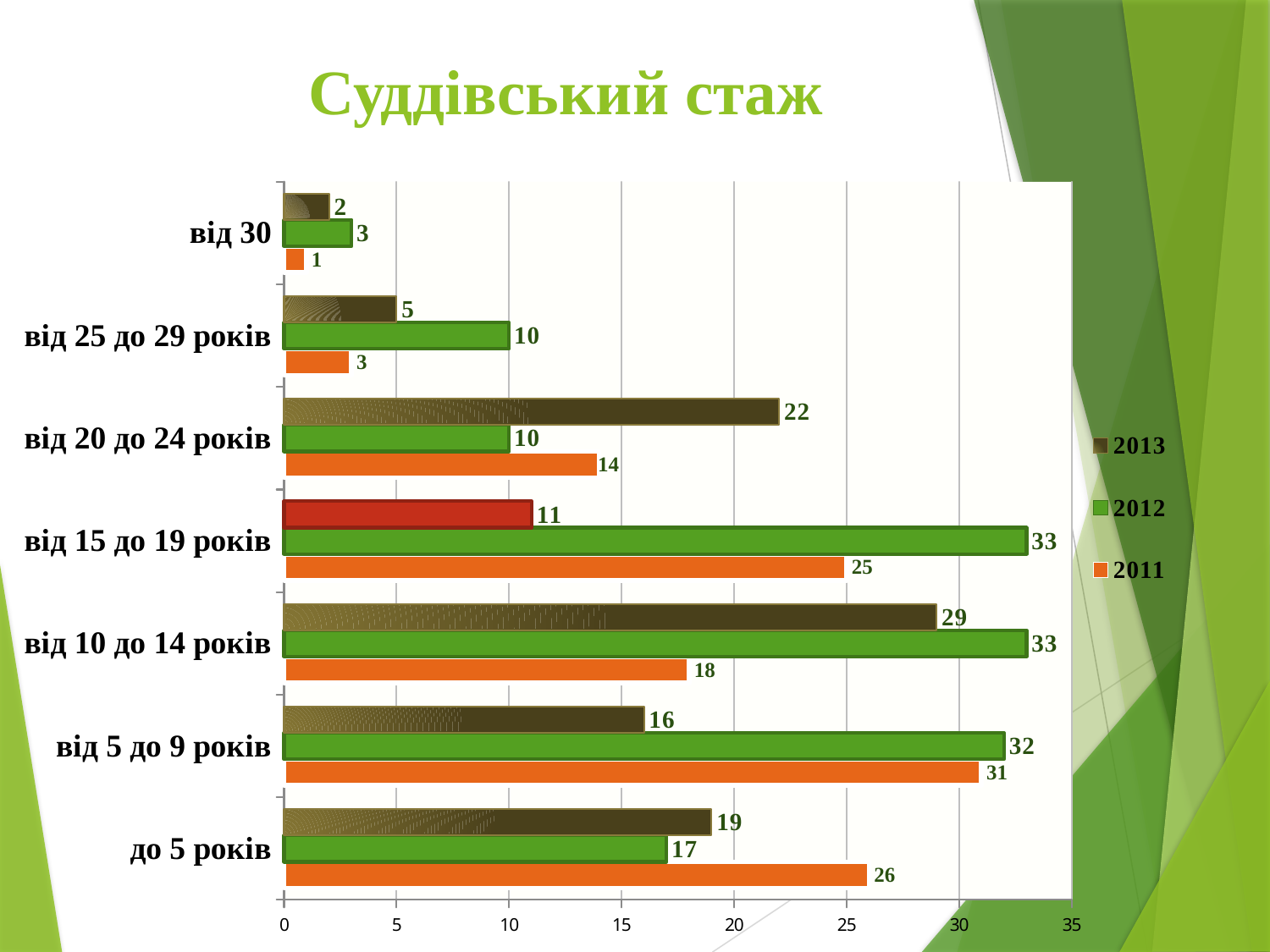
Which category has the lowest value for the 2011 series? від 30 How many series does the legend list? 3 What kind of chart is shown on the slide? bar chart What is the value for 2012 in the category "від 5 до 9 років"? 32 How many categories are shown on the chart? 7 In the category "від 15 до 19 років", which is larger: the 2012 value or the 2011 value? 2012 Which series is shown in orange in the legend? 2011 What is the difference between the 2012 and 2011 values in the category "від 10 до 14 років"? 15 What is the value for 2011 in the category "до 5 років"? 26 What is the value for 2013 in the category "від 20 до 24 років"? 22 Which category has the highest value for the 2013 series? від 10 до 14 років What is the title of the chart? Суддівський стаж